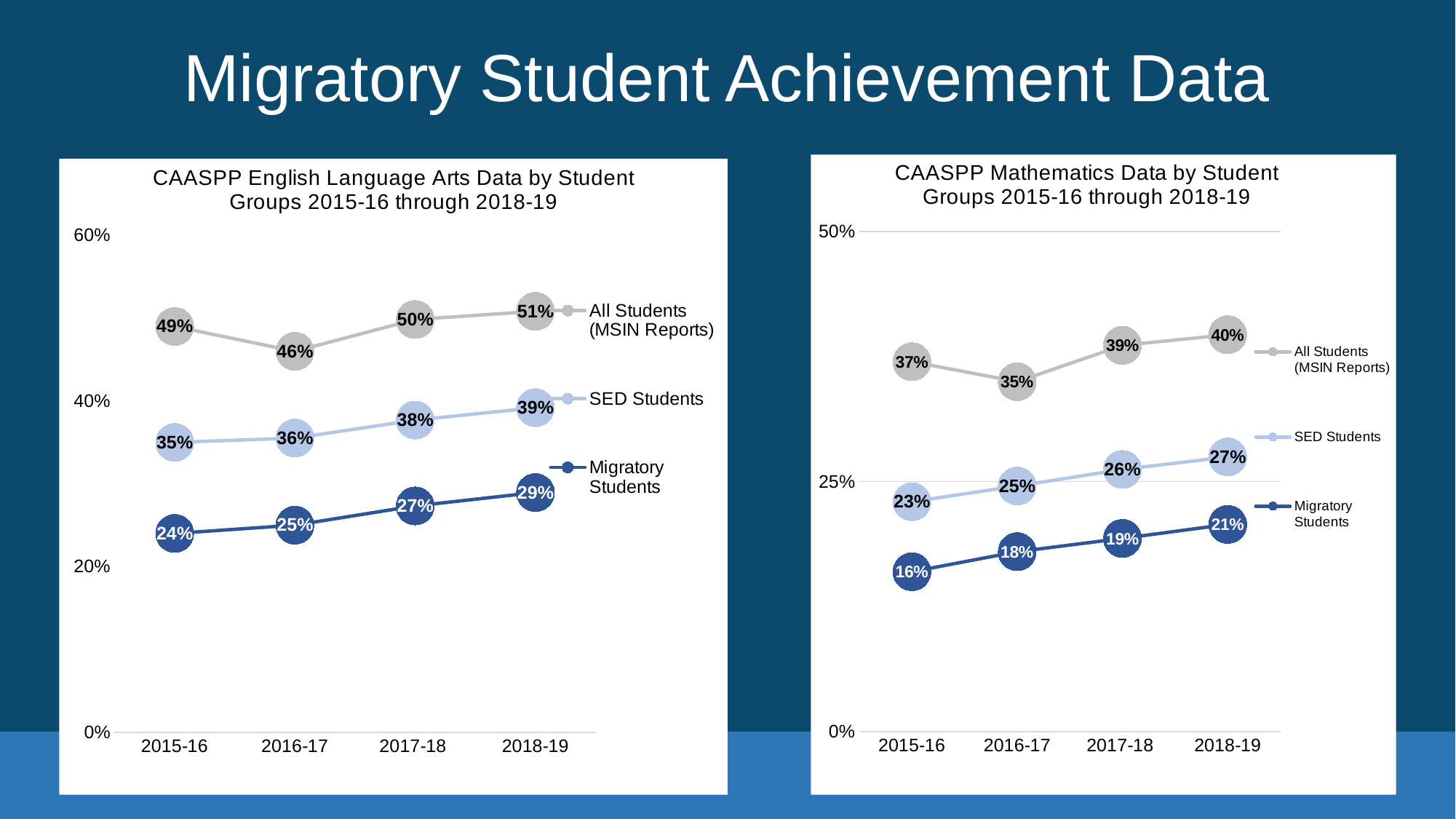
How many series does the legend of the CAASPP Mathematics chart list? 3 In the CAASPP English Language Arts chart, what is the difference between SED Students and Migratory Students in 2015-16? 11% In the CAASPP Mathematics chart, what is the value for All Students (MSIN Reports) in 2016-17? 35% What is the title of the chart on the left side of the slide? CAASPP English Language Arts Data by Student Groups 2015-16 through 2018-19 In the CAASPP English Language Arts chart, what is the value for Migratory Students in 2018-19? 29% In the CAASPP English Language Arts chart, do the Migratory Students values rise or fall from 2015-16 to 2018-19? Rise In the CAASPP Mathematics chart, what is the difference between All Students (MSIN Reports) and Migratory Students in 2018-19? 19% In the CAASPP Mathematics chart, in which year is the Migratory Students value highest? 2018-19 In the CAASPP English Language Arts chart, in which year is the All Students (MSIN Reports) value lowest? 2016-17 In the CAASPP Mathematics chart, which is larger in 2017-18: SED Students or Migratory Students? SED Students What kind of chart is the CAASPP Mathematics Data by Student Groups chart? Line chart How many years are shown on the x axis of the CAASPP English Language Arts chart? 4